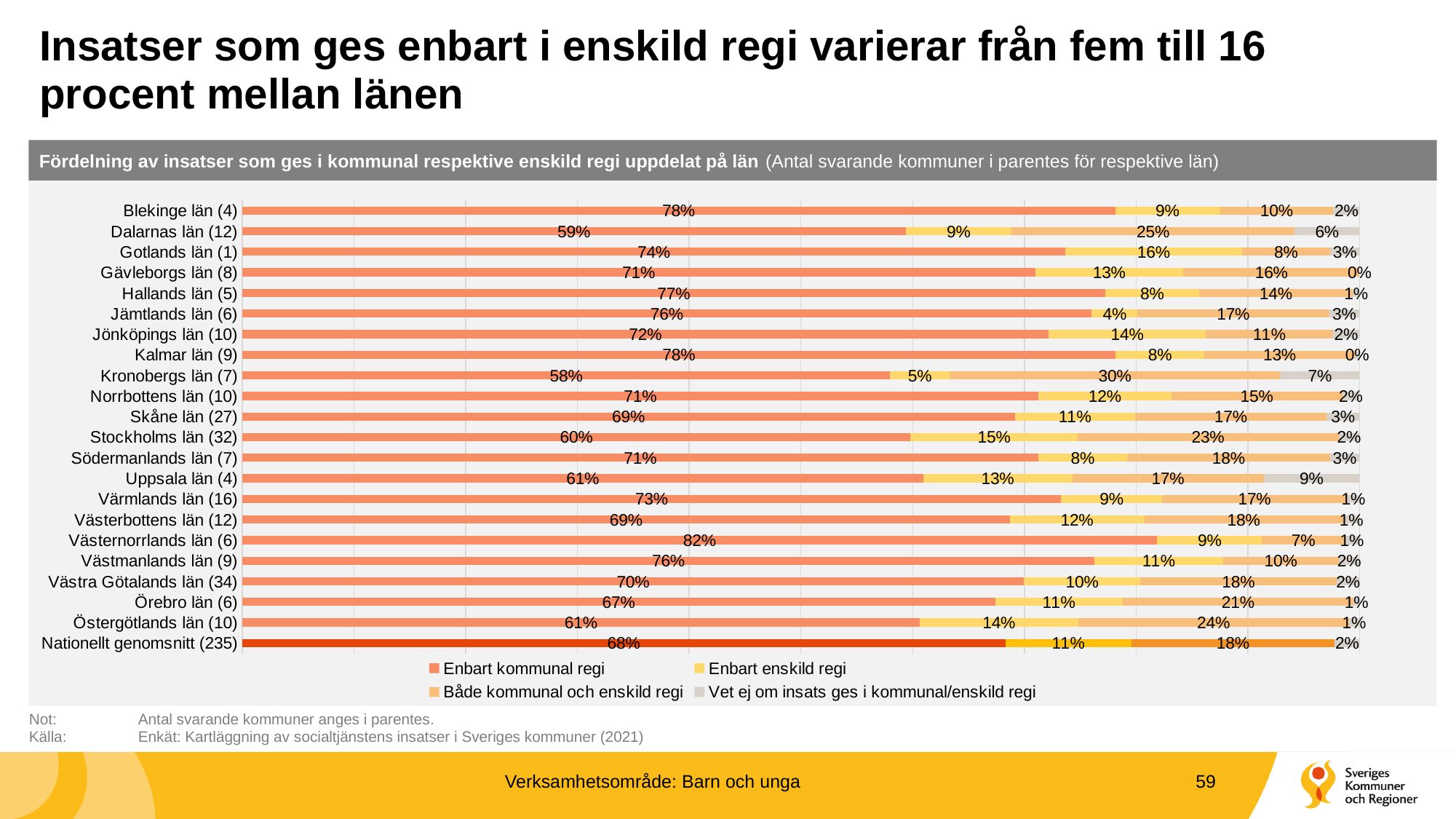
What is the 'Enbart kommunal regi' value for Stockholms län (32)? 60% How many bars (categories) are plotted in the chart? 22 What type of chart is shown on the slide? Stacked bar chart What is the 'Enbart enskild regi' value for Nationellt genomsnitt (235)? 11% Which category has the highest 'Enbart enskild regi' value? Gotlands län (1) Which category has the highest 'Vet ej om insats ges i kommunal/enskild regi' value? Uppsala län (4) Which has a larger 'Både kommunal och enskild regi' value, Östergötlands län (10) or Örebro län (6)? Östergötlands län (10) What is the difference between the 'Enbart kommunal regi' values for Blekinge län (4) and Dalarnas län (12)? 19 percentage points Which category has the lowest 'Enbart kommunal regi' value? Kronobergs län (7) What is the 'Både kommunal och enskild regi' value for Kronobergs län (7)? 30% Which category has the highest 'Enbart kommunal regi' value? Västernorrlands län (6) How many series does the legend list? 4